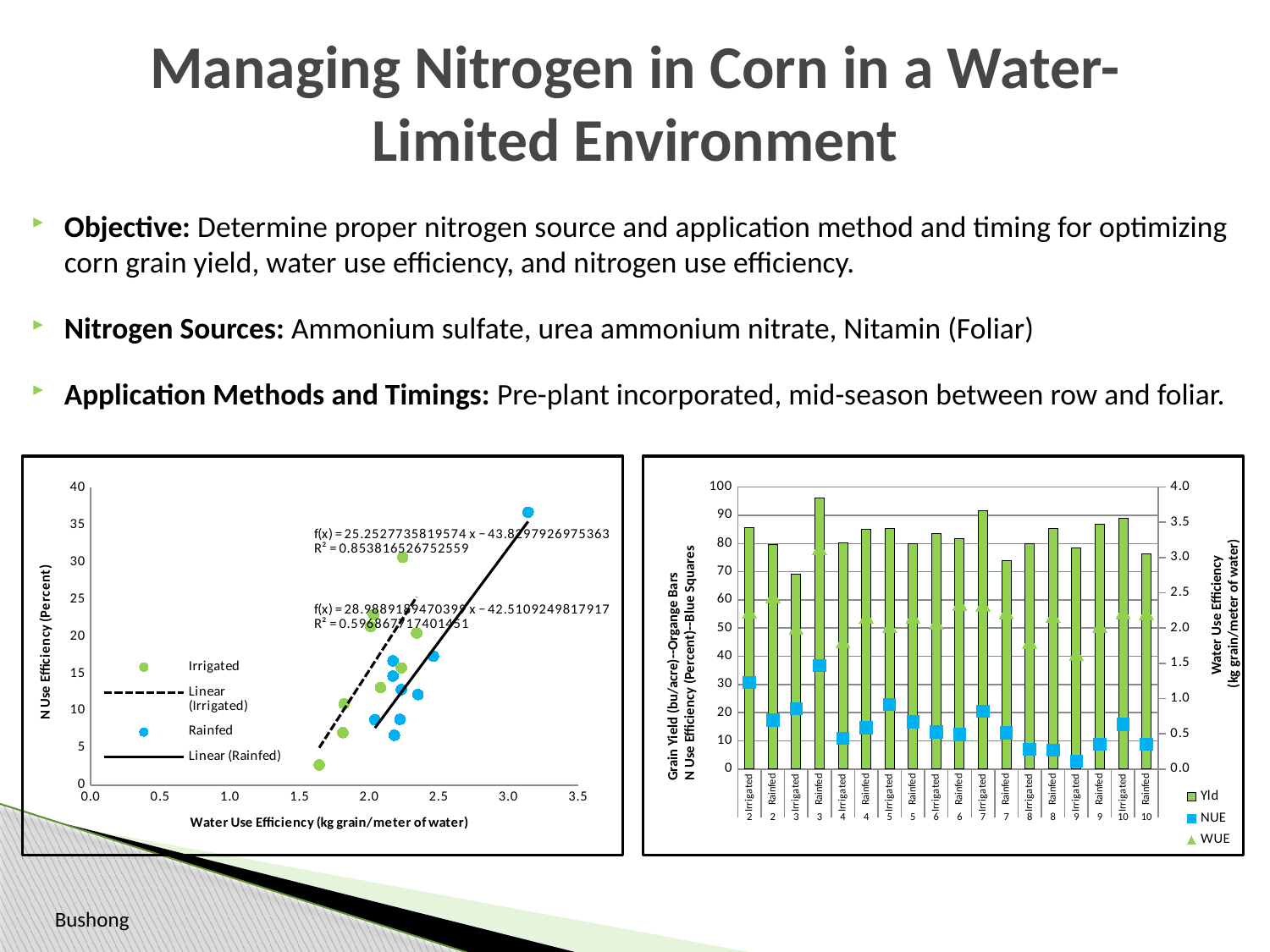
In the left chart, how many entries does the legend list? 4 In the right chart, how many series does the legend list? 3 In the left chart, what is the label of the x axis? Water Use Efficiency (kg grain/meter of water) In the right chart, which category has the tallest Yld bar? 3 Rainfed In the left chart, what is the R² value printed for the upper trendline equation (f(x) = 25.2527735819574 x − 43.8297926975363)? 0.853816526752559 In the right chart, which category has the shortest Yld bar? 3 Irrigated In the right chart, how many categories are shown on the x axis? 18 What type of chart is the chart on the left of the slide? scatter chart In the left chart, is the N Use Efficiency of the highest Rainfed point greater or less than 35? greater In the right chart, is the Yld value for 3 Rainfed greater or less than 90? greater In the right chart, is the Yld value for 7 Rainfed greater or less than 80? less In the right chart, which category has the lowest NUE value? 9 Irrigated